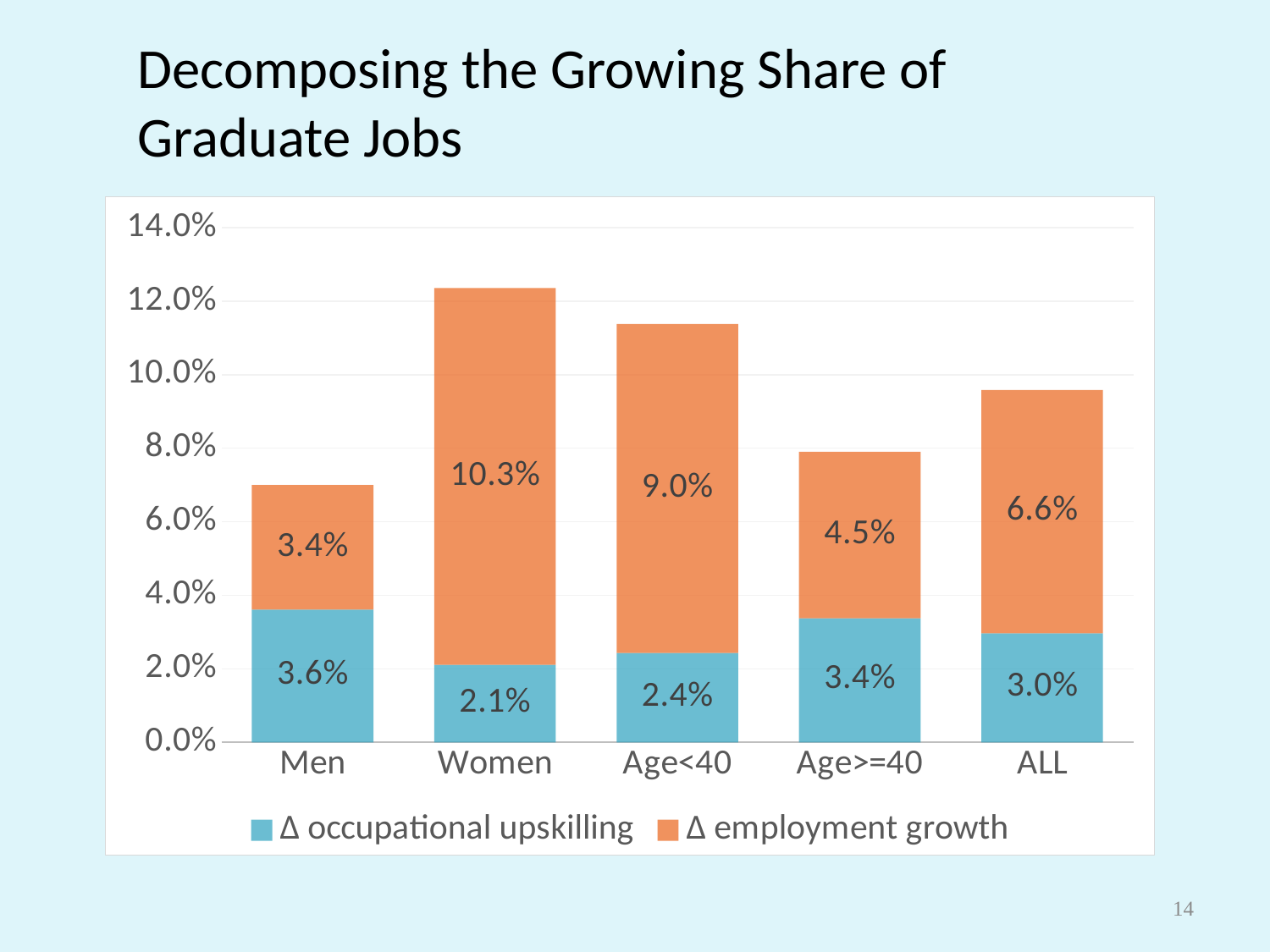
What is the value of Δ employment growth for Women? 10.3% Which is larger: Δ occupational upskilling for Men or for Age>=40? Men Which category has the lowest Δ occupational upskilling value? Women Which category has the highest Δ employment growth value? Women How many categories are shown on the x axis? 5 How many series does the legend list? 2 What type of chart is shown on the slide? stacked bar chart What is the value of Δ occupational upskilling for ALL? 3.0% Is the total of the stacked bar for Women greater or less than 12.0%? greater What is the total of the stacked bar for Men? 7.0% What is the value of Δ occupational upskilling for Age<40? 2.4% What is the difference between Δ employment growth for Age<40 and Age>=40? 4.5%